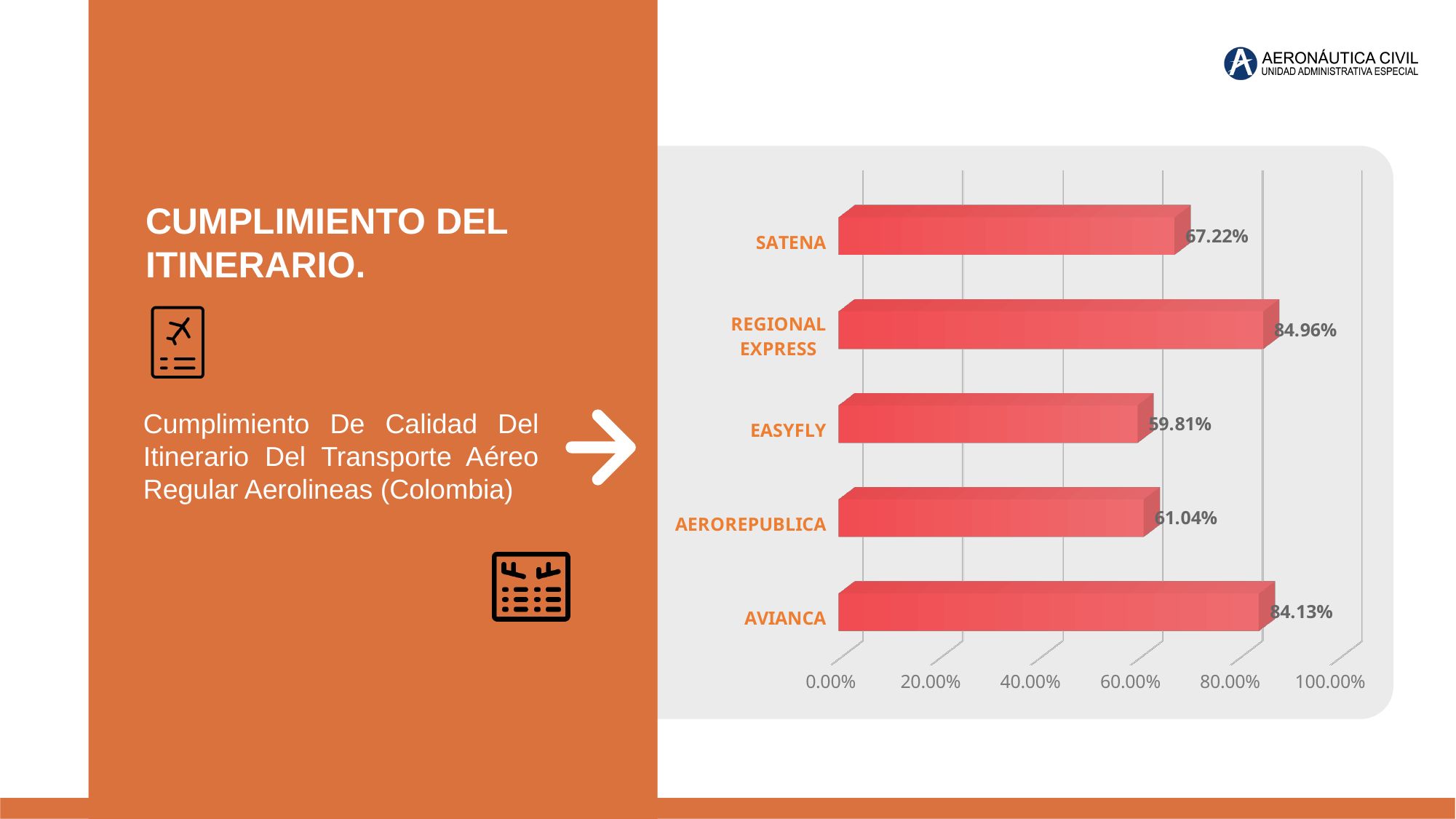
What is the value for EASYFLY? 59.81% What is the difference between the values for SATENA and EASYFLY? 7.41% What is the difference between the values for REGIONAL EXPRESS and AVIANCA? 0.83% How many airlines are shown in the chart? 5 Which airline has the highest value? REGIONAL EXPRESS What is the value for REGIONAL EXPRESS? 84.96% What is the value for SATENA? 67.22% What kind of chart is shown on the slide? Bar chart Which airline has the lowest value? EASYFLY What is the value for AEROREPUBLICA? 61.04% What is the value for AVIANCA? 84.13% Which is larger, the value for SATENA or the value for AEROREPUBLICA? SATENA